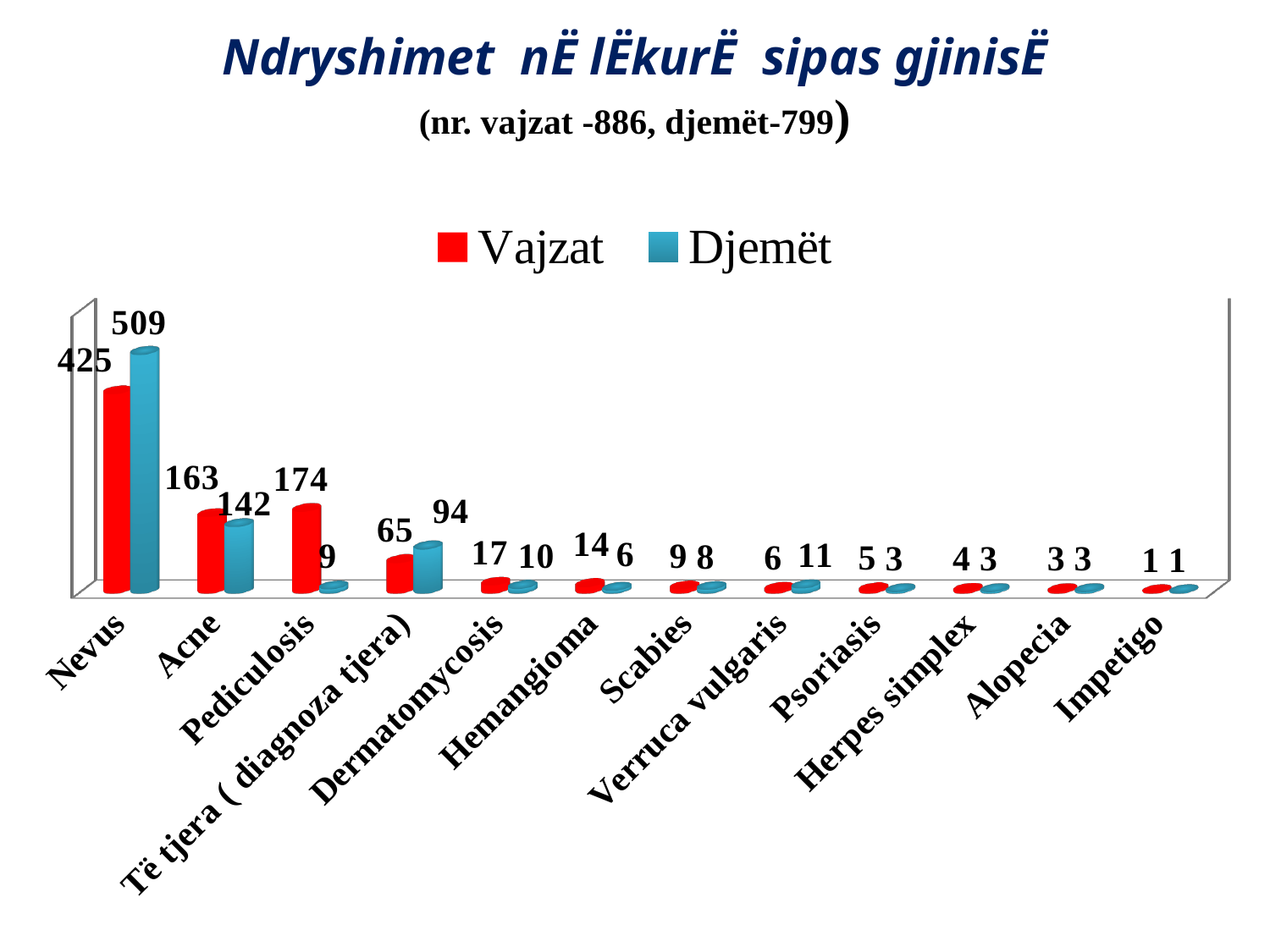
Which category has the highest Djemët value? Nevus What is the Djemët value for Pediculosis? 9 What is the Vajzat value for Nevus? 425 Which category has the lowest Vajzat value? Impetigo What is the Djemët value for Të tjera (diagnoza tjera)? 94 How many series does the legend list? 2 How many categories are shown on the x axis? 12 What is the difference between the Djemët and Vajzat values for Nevus? 84 For Verruca vulgaris, which series has the larger value, Vajzat or Djemët? Djemët What is the difference between the Vajzat and Djemët values for Pediculosis? 165 What kind of chart is shown on the slide? Bar chart For Acne, which series has the larger value, Vajzat or Djemët? Vajzat